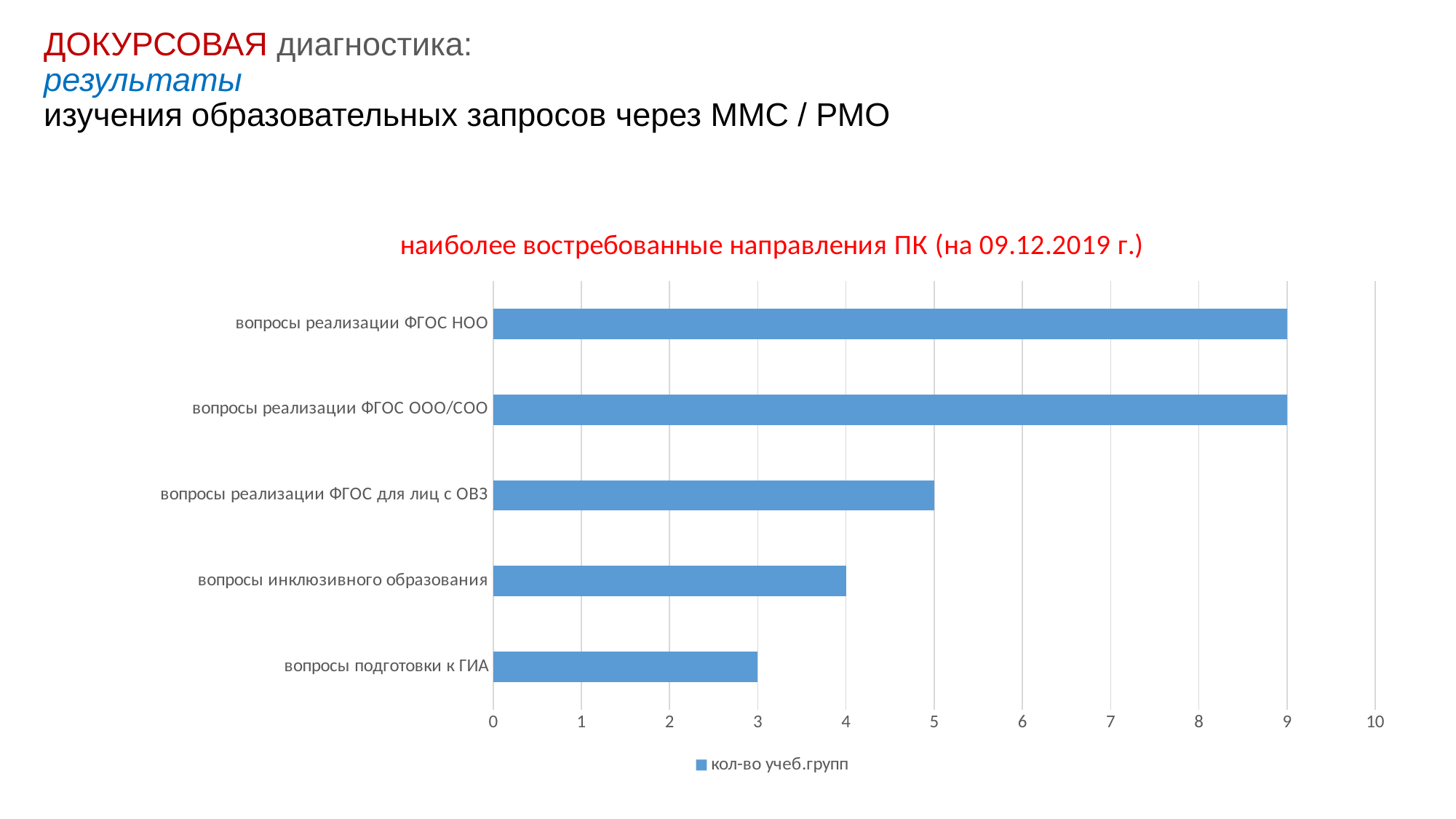
What is the title of the chart? наиболее востребованные направления ПК (на 09.12.2019 г.) Which category has the lowest value? вопросы подготовки к ГИА Which is larger: the value for 'вопросы реализации ФГОС для лиц с ОВЗ' or the value for 'вопросы инклюзивного образования'? вопросы реализации ФГОС для лиц с ОВЗ What is the value for 'вопросы реализации ФГОС НОО'? 9 What is the difference between the values for 'вопросы реализации ФГОС ООО/СОО' and 'вопросы подготовки к ГИА'? 6 How many categories are plotted in the chart? 5 What is the value for 'вопросы подготовки к ГИА'? 3 What kind of chart is shown on the slide? bar chart What is the value for 'вопросы реализации ФГОС для лиц с ОВЗ'? 5 What is the legend entry of the series shown in the chart? кол-во учеб.групп What is the value for 'вопросы инклюзивного образования'? 4 How many series does the legend list? 1